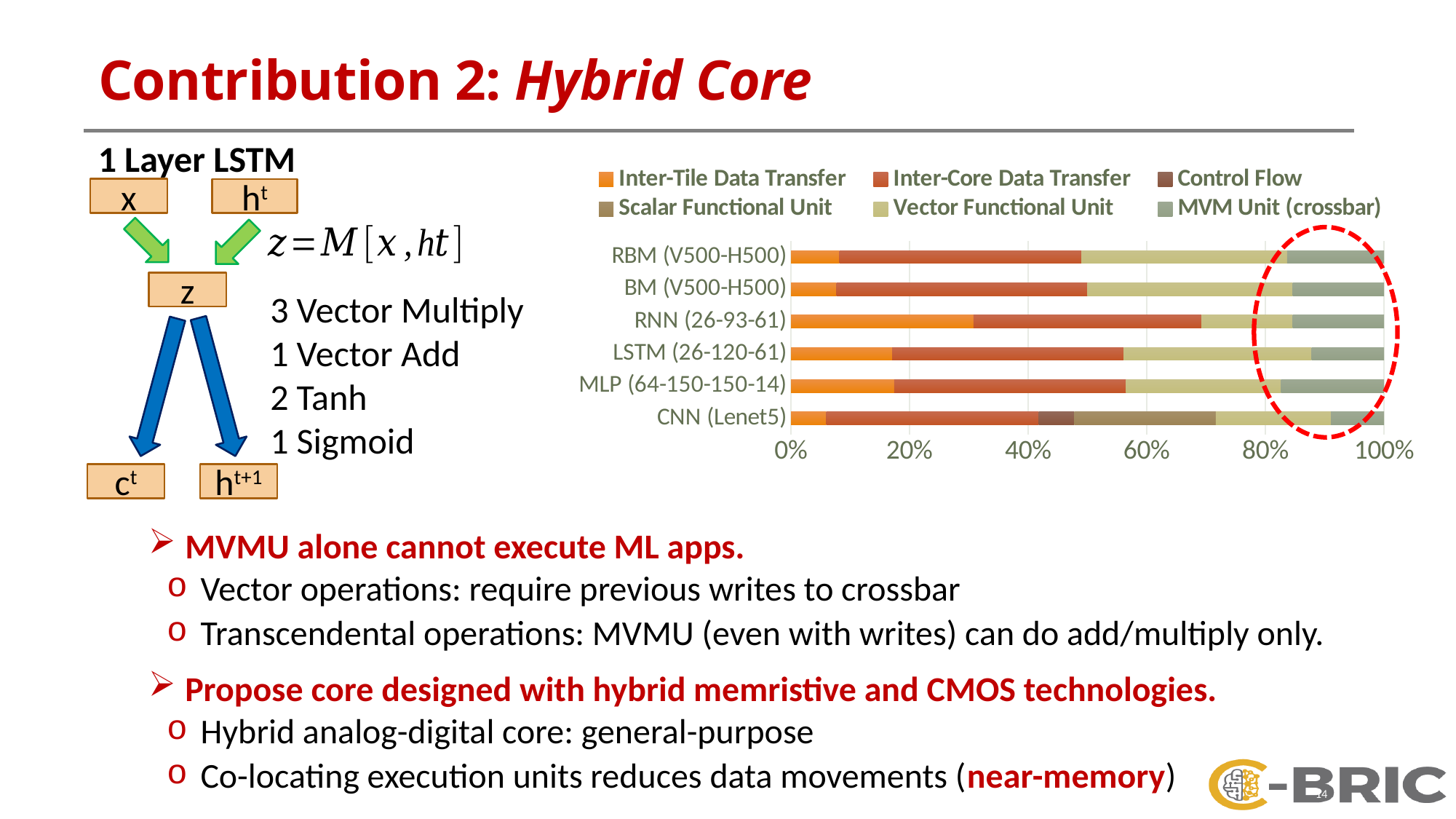
What does each stacked bar in the chart total, according to the x axis? 100% How many categories (workloads) are plotted on the y axis of the chart? 6 What kind of chart is shown on the right of the slide? Stacked bar chart Which series' segments are enclosed by the red dashed ellipse on the chart? MVM Unit (crossbar) How many series does the chart's legend list? 6 Do the combined Inter-Tile and Inter-Core Data Transfer segments for RNN (26-93-61) reach greater or less than 60%? greater Which category is the only one showing visible Control Flow and Scalar Functional Unit segments? CNN (Lenet5) Do the combined Inter-Tile and Inter-Core Data Transfer segments for RBM (V500-H500) reach greater or less than 60%? less Does the Inter-Tile Data Transfer segment for CNN (Lenet5) extend to greater or less than 20%? less Which category has the largest Inter-Tile Data Transfer segment? RNN (26-93-61) Is the Inter-Tile Data Transfer segment larger for RNN (26-93-61) or for LSTM (26-120-61)? RNN (26-93-61)